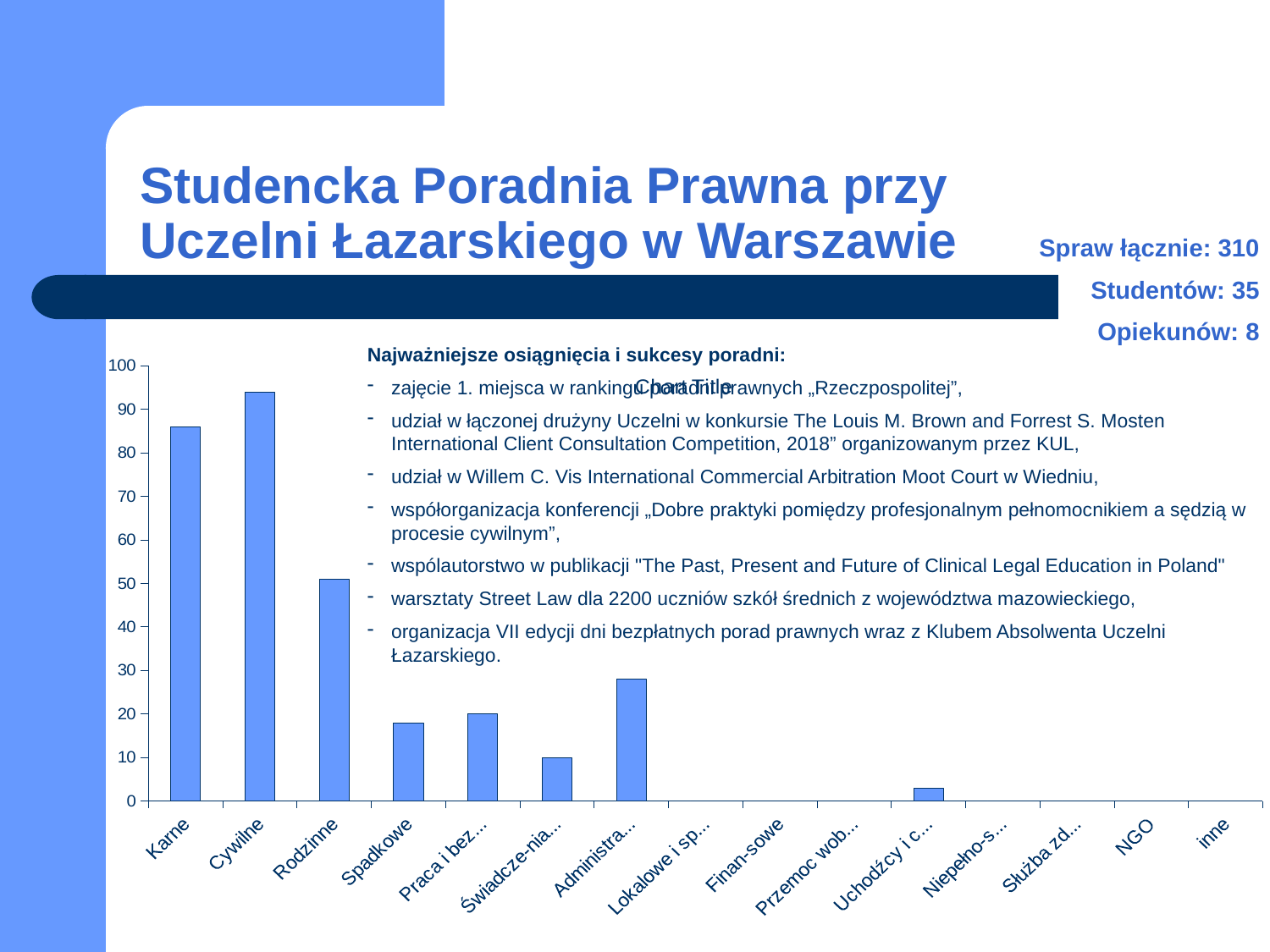
Which is larger, the value for Karne or the value for Cywilne? Cywilne Is the value for Administra... greater or less than 30? less Is the value for Cywilne greater or less than 90? greater Is the value for Karne greater or less than 80? greater What kind of chart is shown on the slide? bar chart What is the title printed above the chart? Chart Title Which is larger, the value for Rodzinne or the value for Administra...? Rodzinne How many categories are shown on the x axis of the chart? 15 Which category has the highest bar in the chart? Cywilne